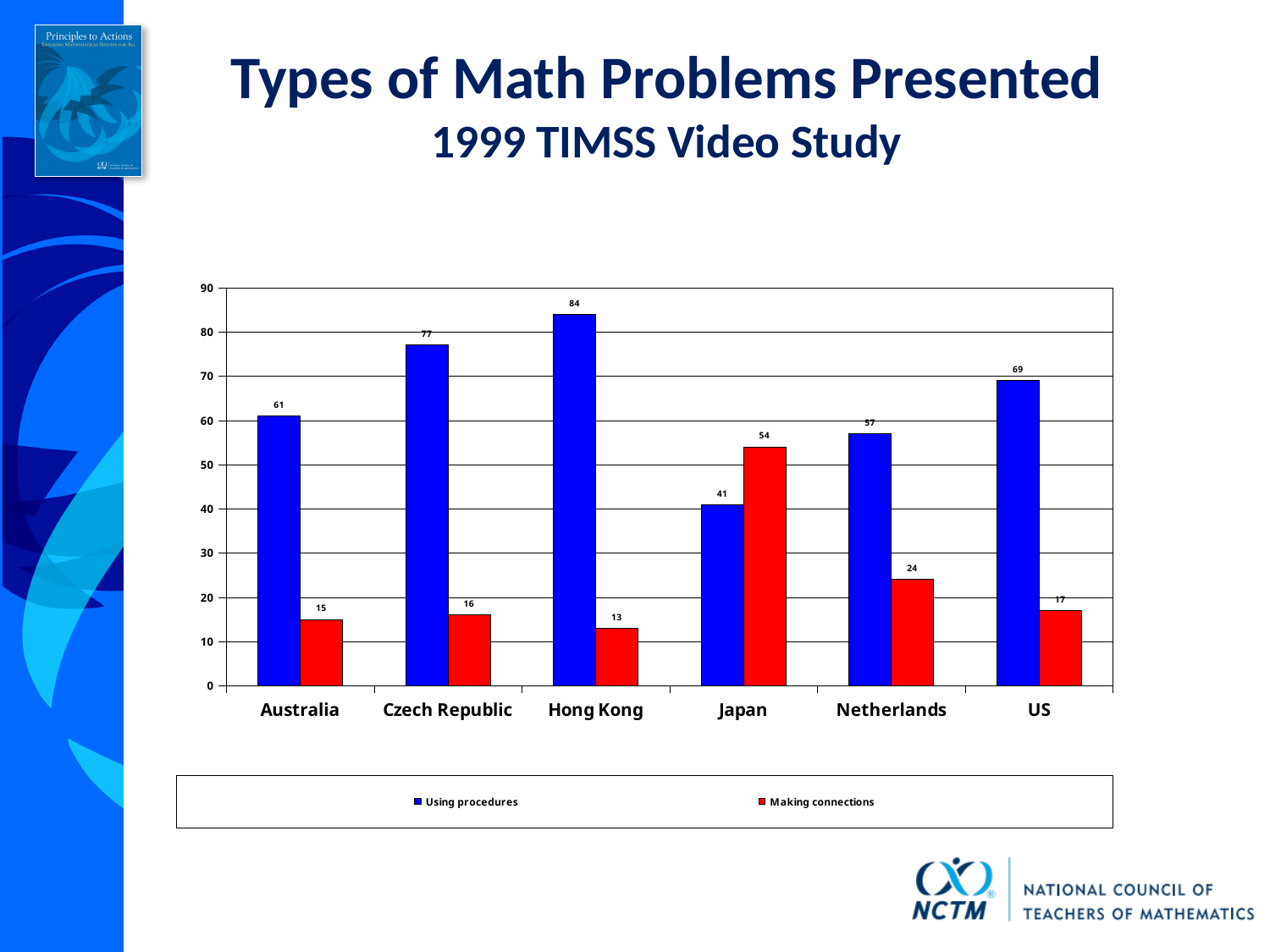
Is the value for Using procedures in Australia greater or less than 50? greater How many series does the legend list? 2 What is the difference between Using procedures and Making connections for the US? 52 What is the value for Making connections in the Netherlands? 24 What is the value for Using procedures in Hong Kong? 84 How many countries are shown on the x axis? 6 Which colour represents Making connections in the chart? red What is the value for Making connections in Japan? 54 Which country has the lowest value for Making connections? Hong Kong Which country has the highest value for Using procedures? Hong Kong Which is larger for Japan: Using procedures or Making connections? Making connections What kind of chart is shown on the slide? bar chart